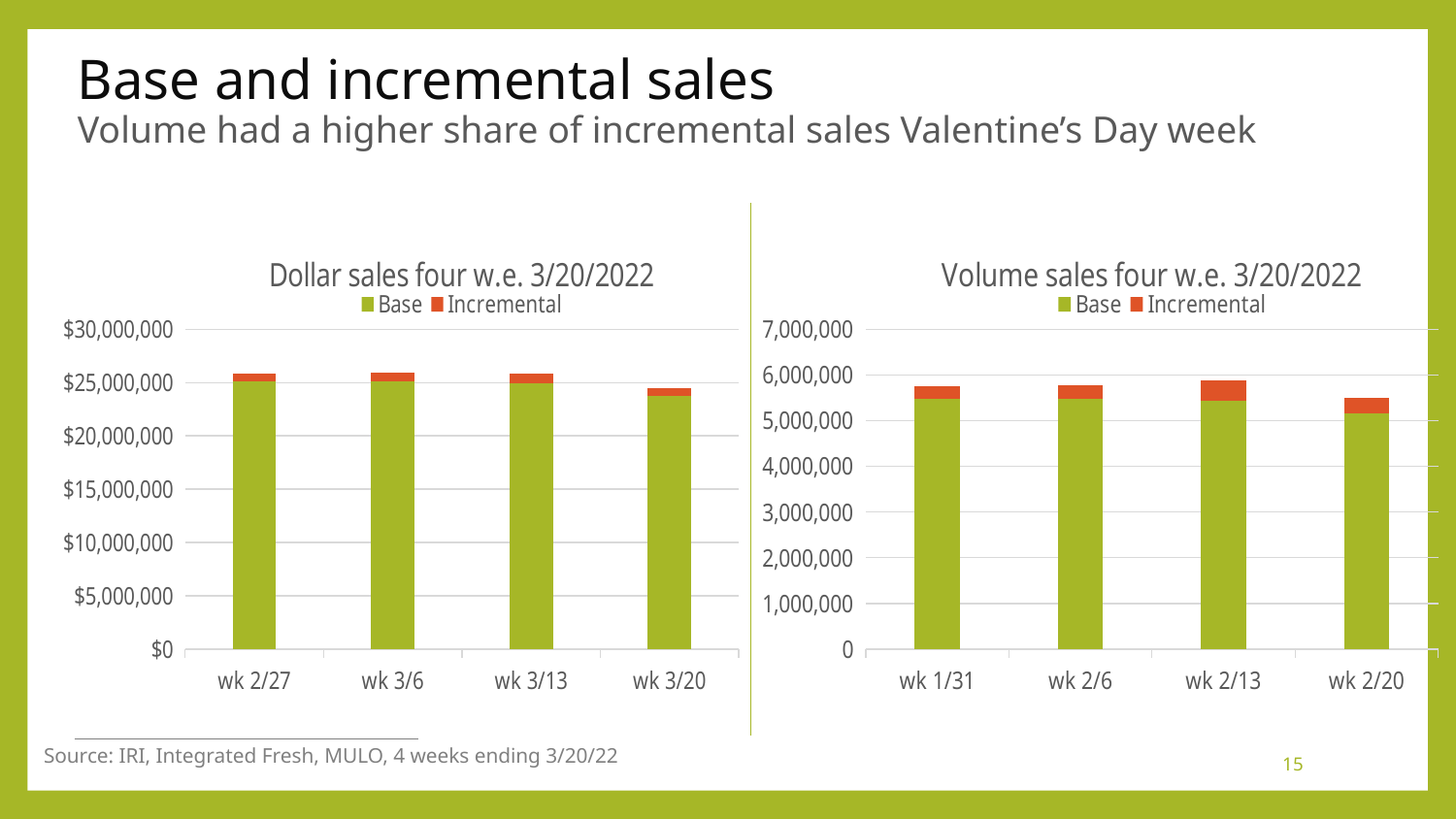
What is the title of the chart on the right side of the slide? Volume sales four w.e. 3/20/2022 In the 'Dollar sales four w.e. 3/20/2022' chart, is the total bar for wk 2/27 greater or less than $20,000,000? greater How many weeks are shown on the x axis of the 'Dollar sales four w.e. 3/20/2022' chart? 4 What are the two series named in the legend of the 'Dollar sales four w.e. 3/20/2022' chart? Base and Incremental In the 'Dollar sales four w.e. 3/20/2022' chart, is the total bar for wk 3/6 larger or smaller than the total bar for wk 3/20? larger In the 'Dollar sales four w.e. 3/20/2022' chart, which week has the lowest total bar? wk 3/20 How many series does the legend of the 'Volume sales four w.e. 3/20/2022' chart list? 2 How many bars are plotted in the 'Volume sales four w.e. 3/20/2022' chart? 4 In the 'Volume sales four w.e. 3/20/2022' chart, which week has the lowest total bar? wk 2/20 In the 'Volume sales four w.e. 3/20/2022' chart, which week has the largest Incremental segment? wk 2/13 What kind of chart is the 'Dollar sales four w.e. 3/20/2022' chart? stacked bar chart In the 'Volume sales four w.e. 3/20/2022' chart, is the total bar for wk 2/20 greater or less than 5,000,000? greater